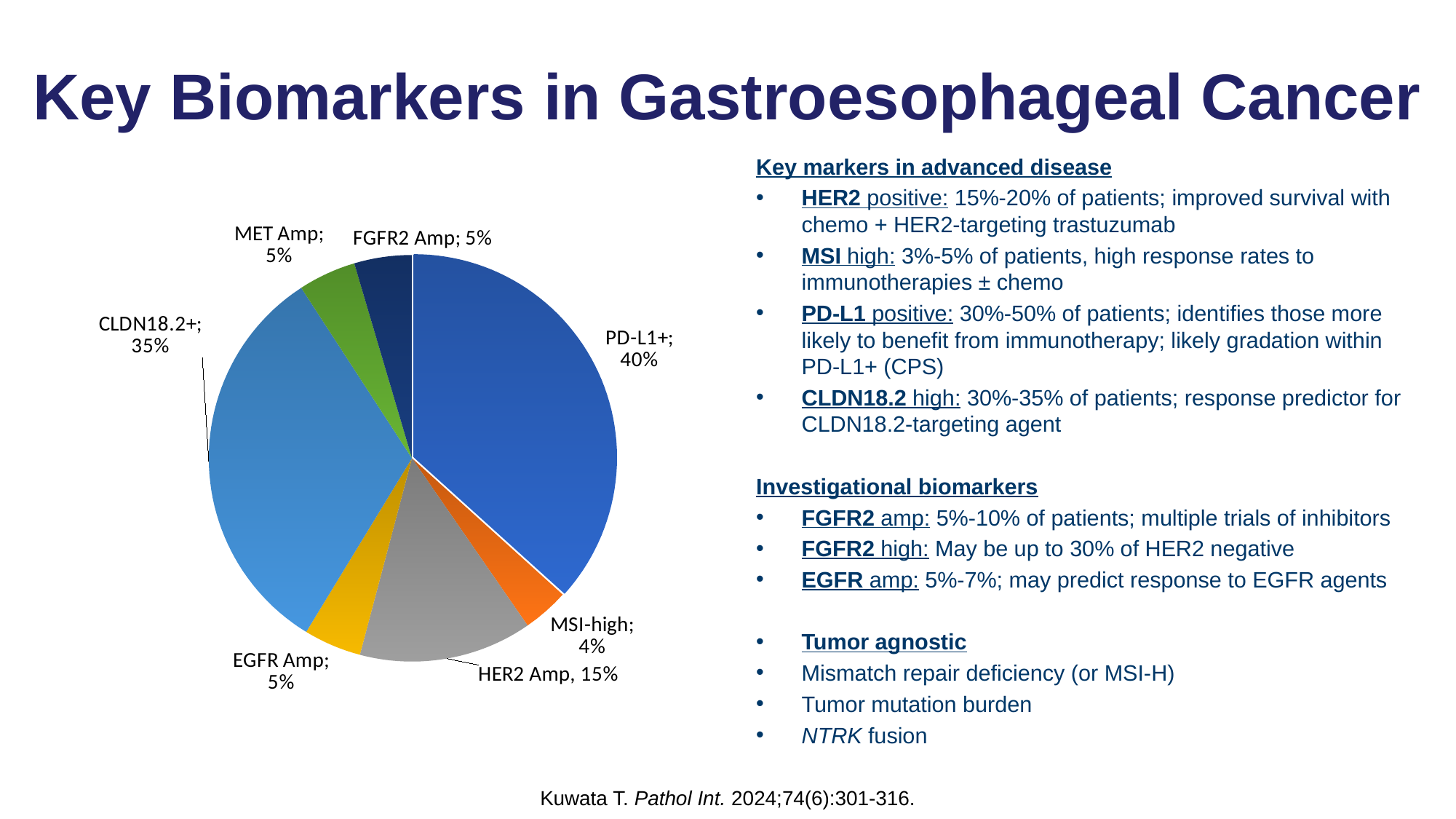
How many categories are shown in the pie chart? 7 What kind of chart is shown on the slide? Pie chart What is the value for PD-L1+ in the pie chart? 40% What is the value for HER2 Amp in the pie chart? 15% Which is larger, the HER2 Amp slice or the EGFR Amp slice? HER2 Amp What is the value for MSI-high in the pie chart? 4% What is the difference between the PD-L1+ and CLDN18.2+ values? 5% What is the difference between the HER2 Amp and MSI-high values? 11% Which category has the largest slice in the pie chart? PD-L1+ What colour is the PD-L1+ slice in the pie chart? Dark blue Which category has the smallest slice in the pie chart? MSI-high What is the value for CLDN18.2+ in the pie chart? 35%